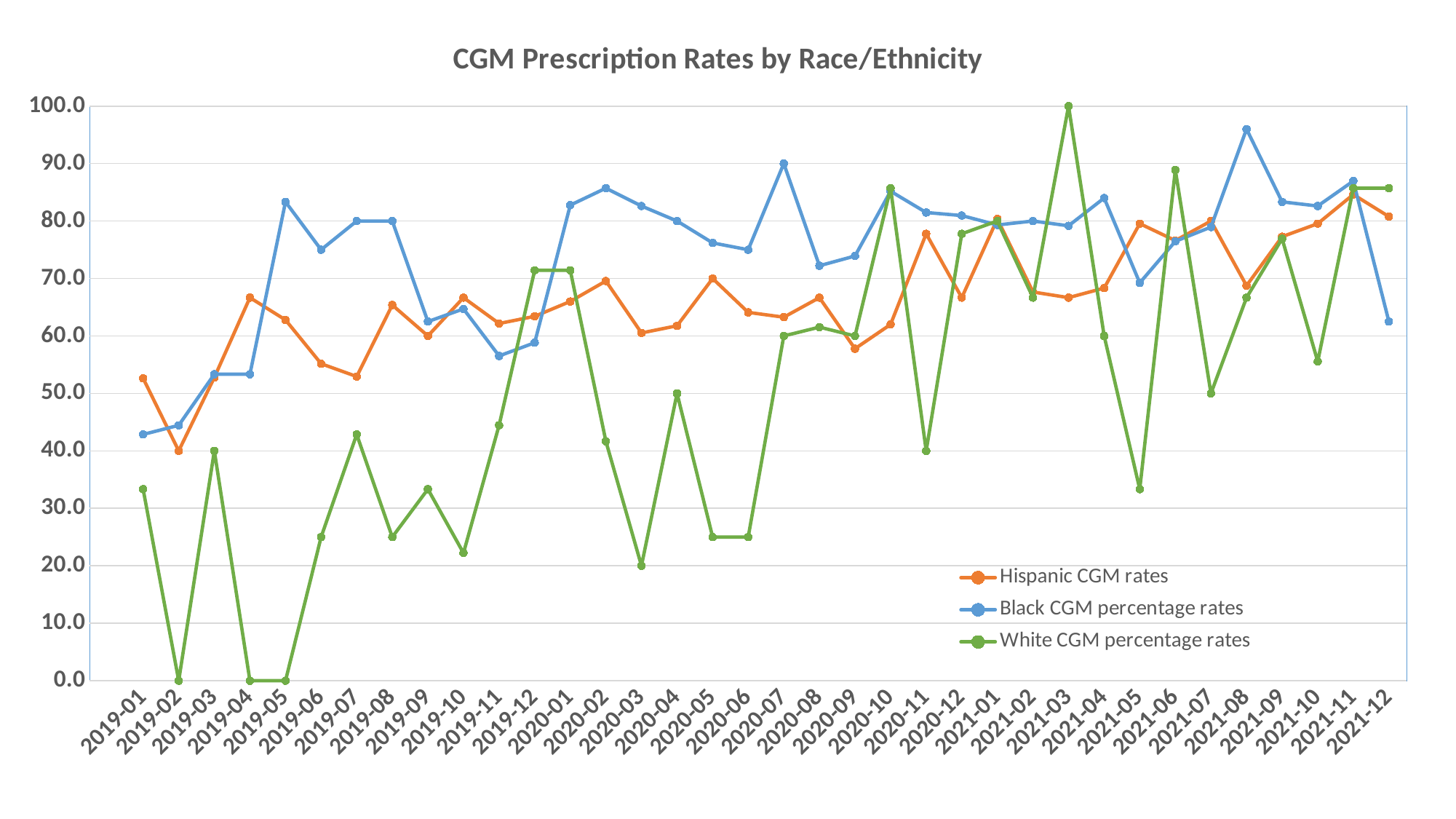
What is the White CGM percentage rate for 2021-03? 100.0 Is the White CGM percentage rate for 2019-06 greater or less than 30.0? less What is the White CGM percentage rate for 2019-02? 0.0 Is the Black CGM percentage rate for 2021-08 greater or less than 90.0? greater What kind of chart is shown on the slide? line chart In which month does the White CGM percentage rate reach its highest value? 2021-03 How many months are plotted along the x axis? 36 How many series does the legend list? 3 Overall, do the Hispanic CGM rates rise or fall from 2019-01 to 2021-12? rise In which month is the Hispanic CGM rate at its lowest? 2019-02 In which month does the Black CGM percentage rate reach its highest value? 2021-08 In 2020-07, which series has the higher value: Black CGM percentage rates or Hispanic CGM rates? Black CGM percentage rates